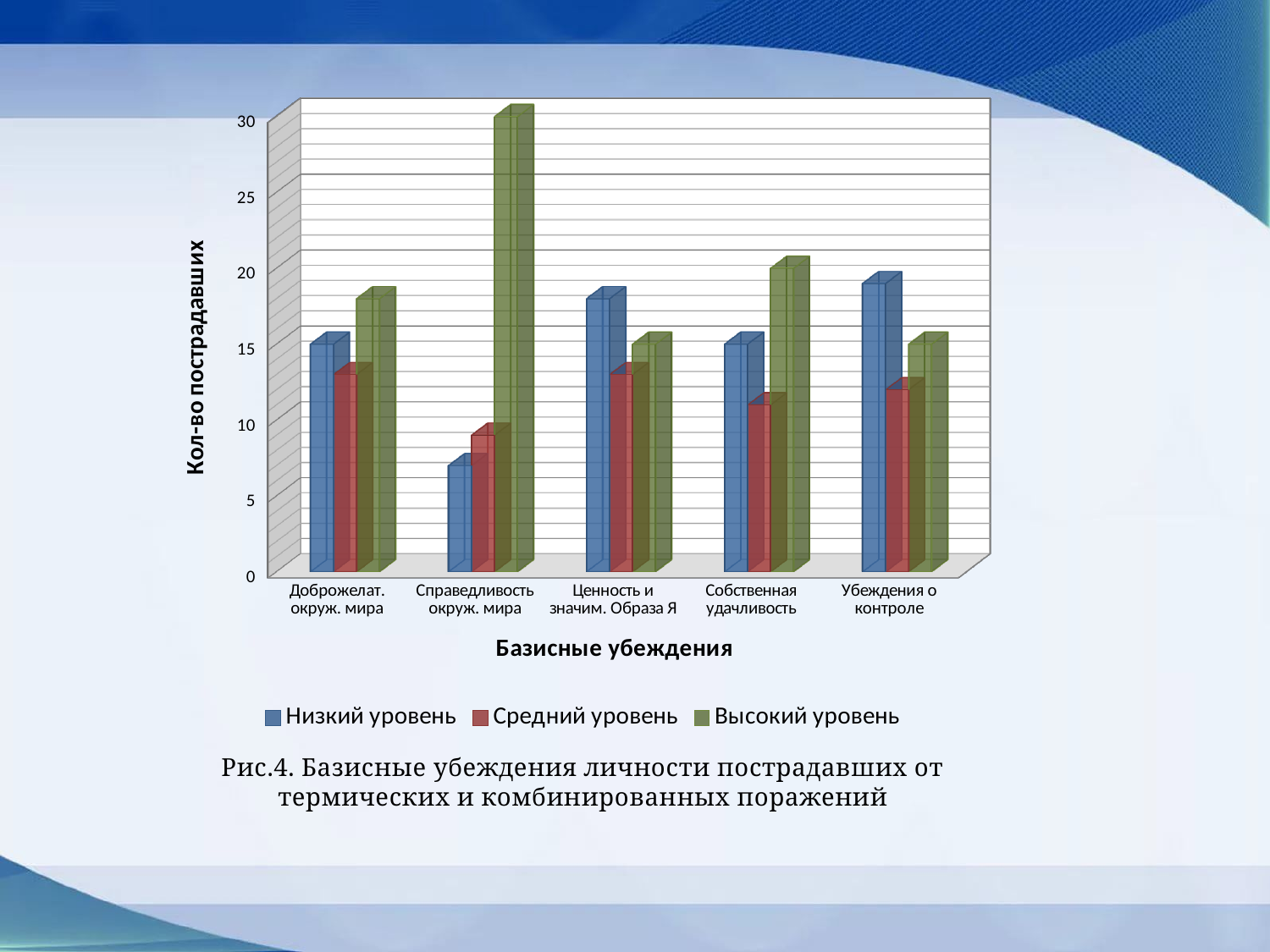
What kind of chart is shown on the slide? bar chart For Убеждения о контроле, which is larger: Низкий уровень or Высокий уровень? Низкий уровень How many series does the legend list? 3 What is the title of the horizontal axis? Базисные убеждения Which category has the lowest Низкий уровень bar? Справедливость окруж. мира Is the Средний уровень value for Собственная удачливость greater or less than 15? less Is the Высокий уровень value for Справедливость окруж. мира greater or less than 25? greater For Собственная удачливость, which is larger: Высокий уровень or Средний уровень? Высокий уровень What is the title of the vertical axis? Кол-во пострадавших Which category has the highest Высокий уровень bar? Справедливость окруж. мира Is the Низкий уровень value for Справедливость окруж. мира greater or less than 10? less How many categories are shown on the x axis? 5